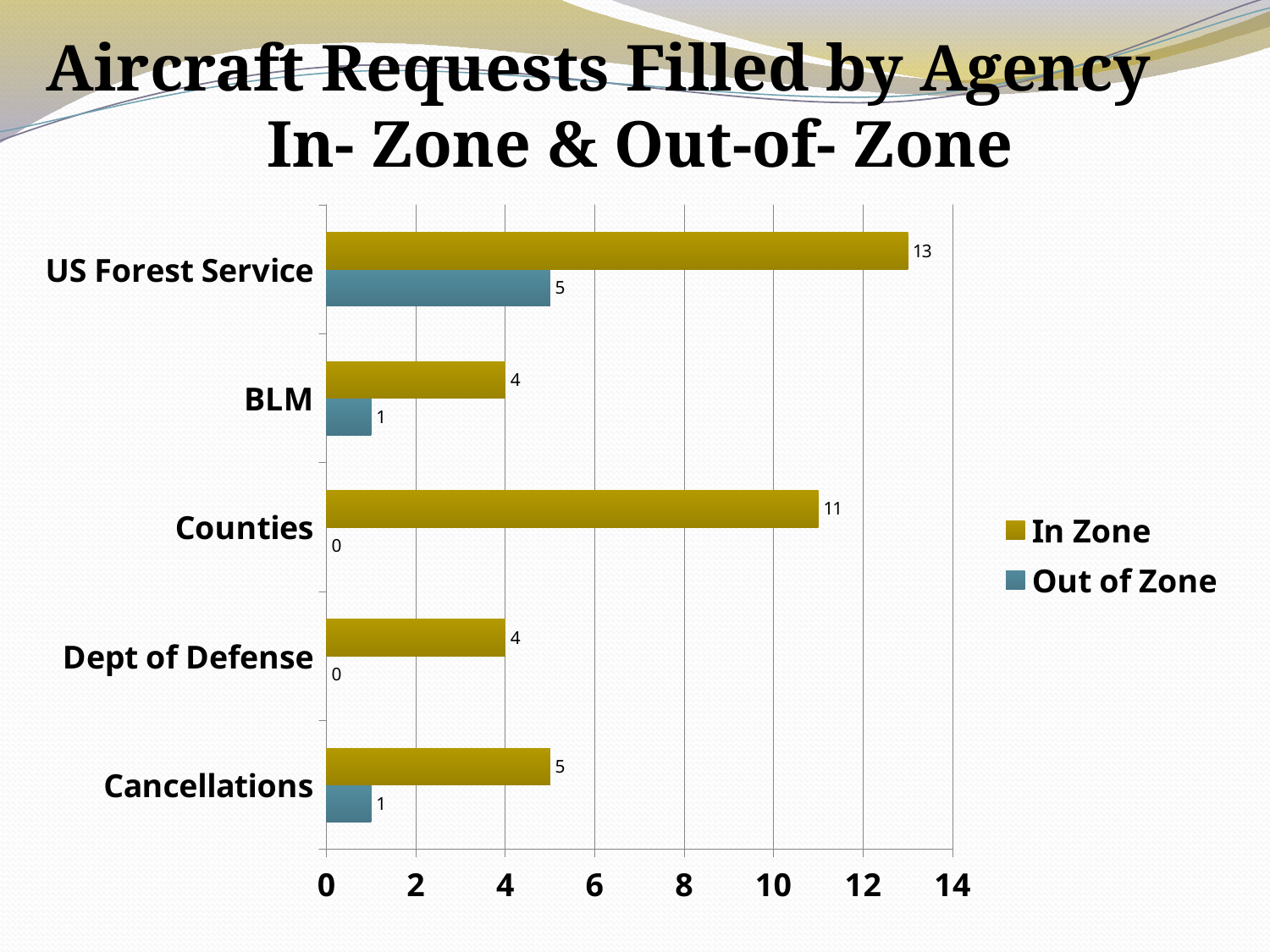
How many categories are shown on the chart? 5 What is the difference between the In Zone and Out of Zone values for US Forest Service? 8 What kind of chart is shown on the slide? Bar chart What is the In Zone value for Counties? 11 What is the title of the chart? Aircraft Requests Filled by Agency In- Zone & Out-of- Zone What is the Out of Zone value for BLM? 1 What is the In Zone value for US Forest Service? 13 Which is larger, the In Zone value for Counties or the In Zone value for Cancellations? Counties Which category has the highest In Zone value? US Forest Service How many series does the legend list? 2 Which category has the lowest In Zone value? BLM and Dept of Defense (tied at 4) What is the Out of Zone value for Dept of Defense? 0